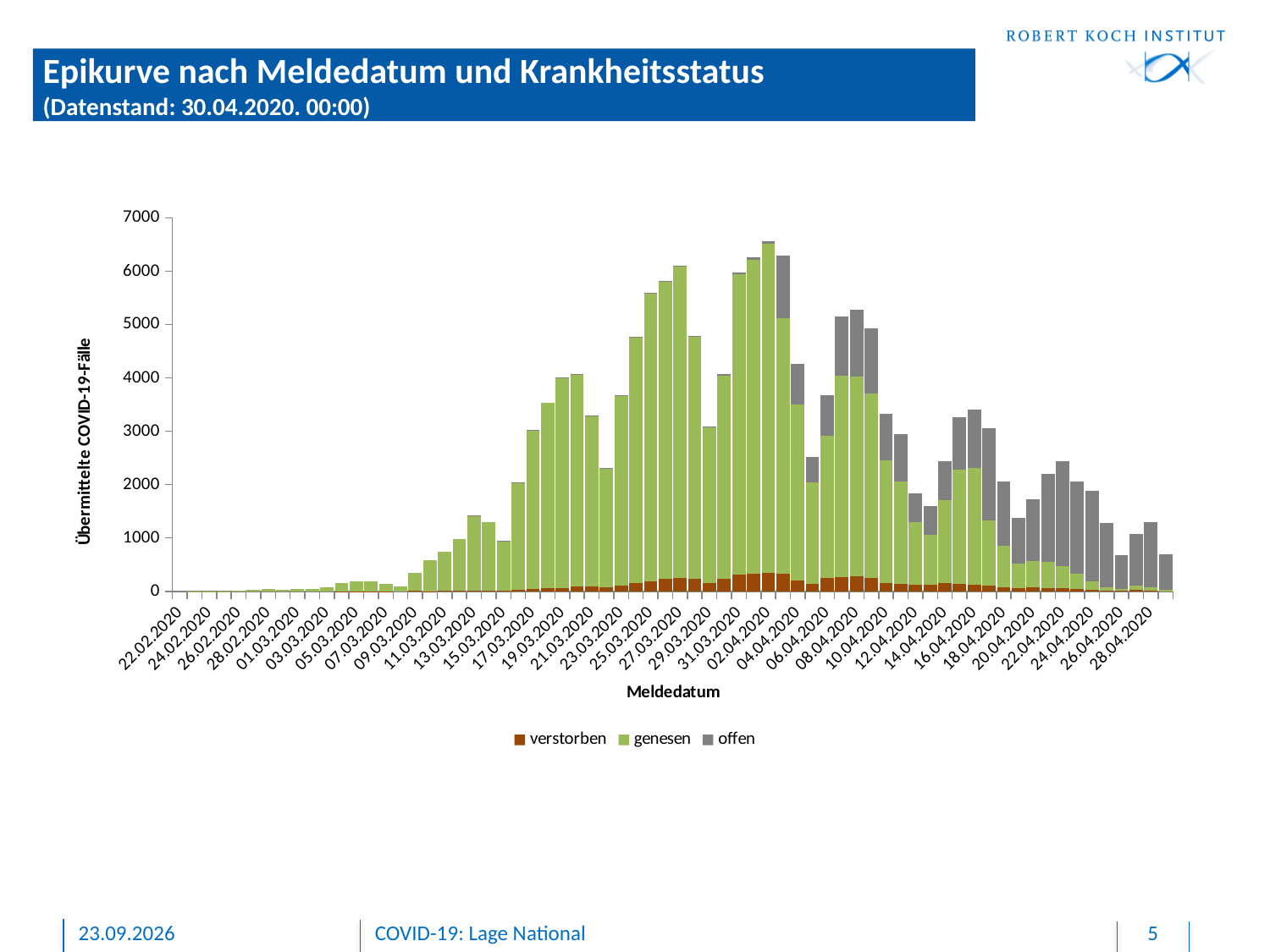
What kind of chart is shown on the slide? stacked bar chart Is the total value for 02.04.2020 greater or less than 5000? greater Is the total value for 22.02.2020 greater or less than 1000? less How many series does the legend list? 3 Is the total value for 14.04.2020 greater or less than 3000? less What are the three series named in the legend? verstorben, genesen, offen Which series makes up the largest part of the bar on 26.03.2020? genesen Which date has the larger total, 26.03.2020 or 14.04.2020? 26.03.2020 Do the totals generally rise or fall from 22.02.2020 to 02.04.2020? rise What is the label of the y axis? Übermittelte COVID-19-Fälle